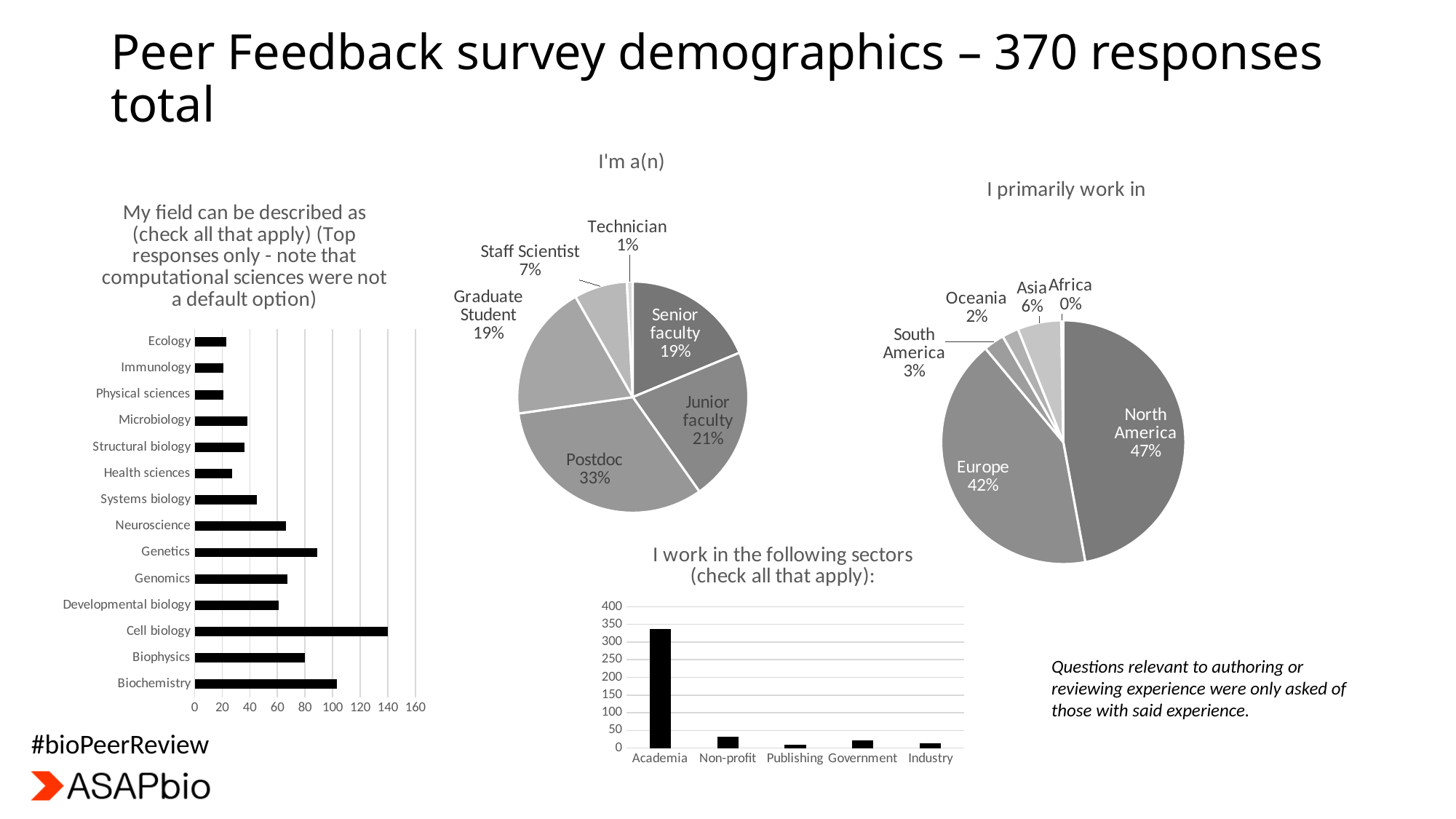
In the 'I primarily work in' pie chart, what percentage of respondents work in Europe? 42% In the 'My field can be described as' chart, which field has the highest count? Cell biology In the 'My field can be described as' chart, is the value for Cell biology greater or less than 120? greater In the 'I primarily work in' pie chart, which region has the largest share? North America In the 'I'm a(n)' pie chart, what percentage of respondents are Postdocs? 33% In the 'I primarily work in' pie chart, how many regions are shown? 6 In the 'I'm a(n)' pie chart, which category has the smallest share? Technician In the 'I'm a(n)' pie chart, what is the difference in percentage points between Postdoc and Junior faculty? 12% In the 'I work in the following sectors' chart, is the value for Academia greater or less than 300? greater In the 'I primarily work in' pie chart, which is larger: Asia or South America? Asia In the 'I'm a(n)' pie chart, which category has the largest share? Postdoc In the 'My field can be described as' chart, how many fields are listed? 14